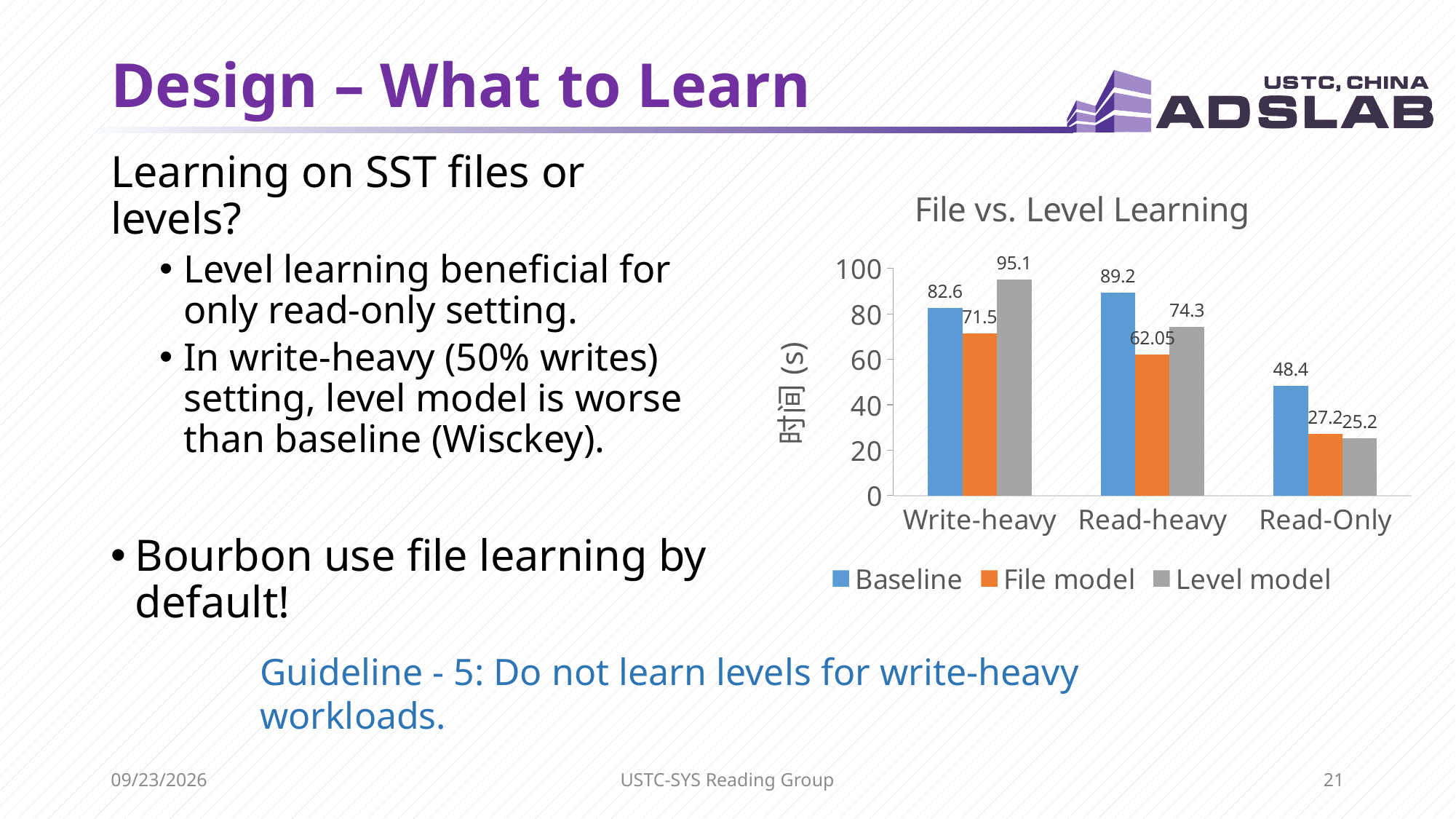
What is the Baseline value for Write-heavy? 82.6 How many categories are shown on the x axis? 3 Which category has the highest Level model value? Write-heavy What is the title of the chart? File vs. Level Learning Is the File model value for Write-heavy greater or less than 80? less What is the Level model value for Read-Only? 25.2 What kind of chart is shown? bar chart What is the File model value for Read-heavy? 62.05 Which category has the lowest Baseline value? Read-Only What is the difference between the Level model and Baseline values for Write-heavy? 12.5 Which is larger for Read-heavy: the Baseline value or the Level model value? Baseline How many series does the legend list? 3